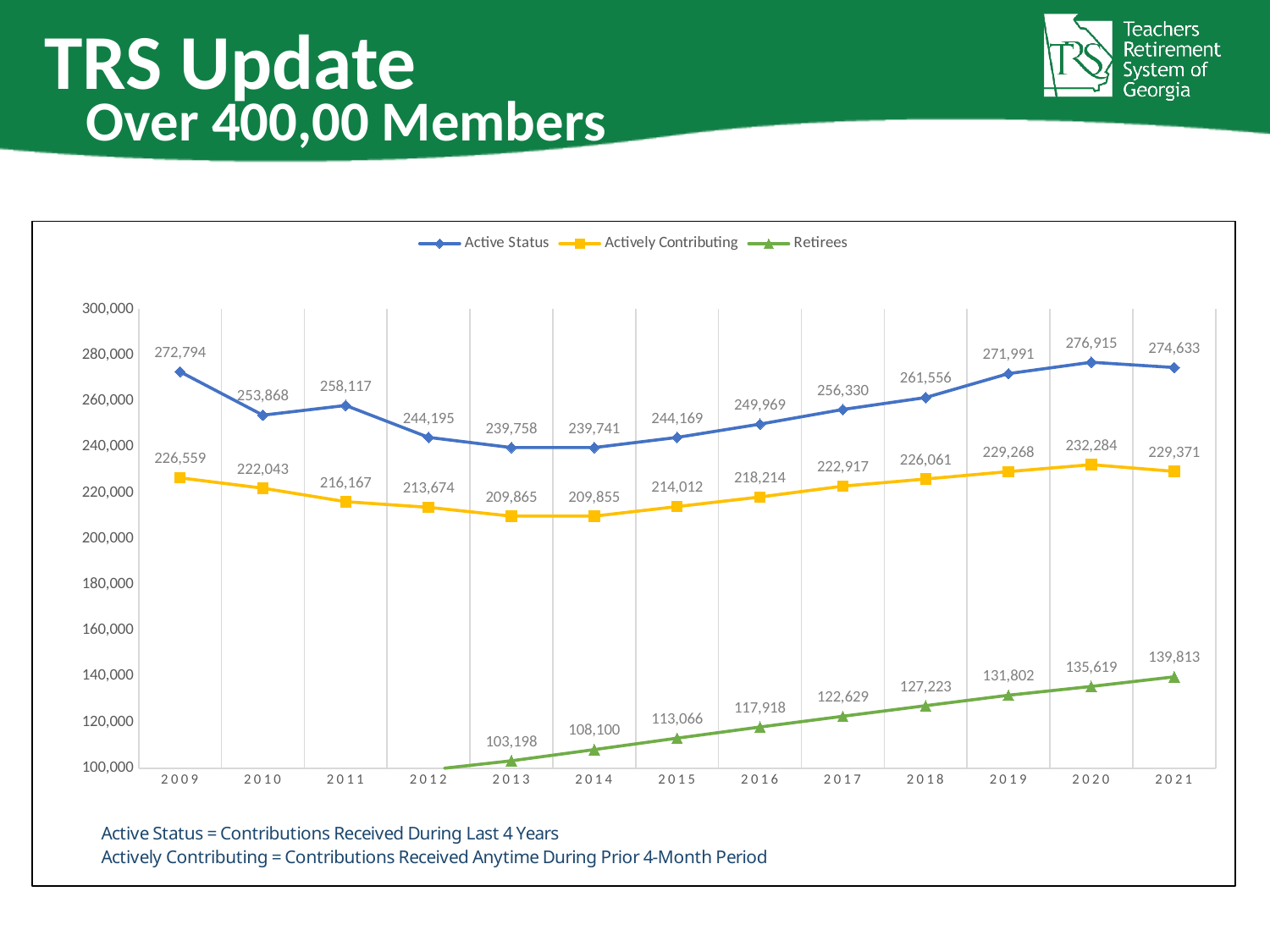
How many series does the legend list? 3 What is the Active Status value for 2009? 272,794 What is the Retirees value for 2021? 139,813 Is the Active Status value for 2009 greater or less than 260,000? greater In which year is the Active Status series at its highest? 2020 What is the Actively Contributing value for 2016? 218,214 By how much did the Retirees value increase from 2013 to 2021? 36,615 In which year is the Actively Contributing series at its highest? 2020 Does the Retirees series rise or fall from 2013 to 2021? rise In which labeled year is the Retirees series at its lowest? 2013 Which is larger in 2011: the Active Status value or the Actively Contributing value? Active Status What is the difference between the Active Status and Actively Contributing values in 2021? 45,262